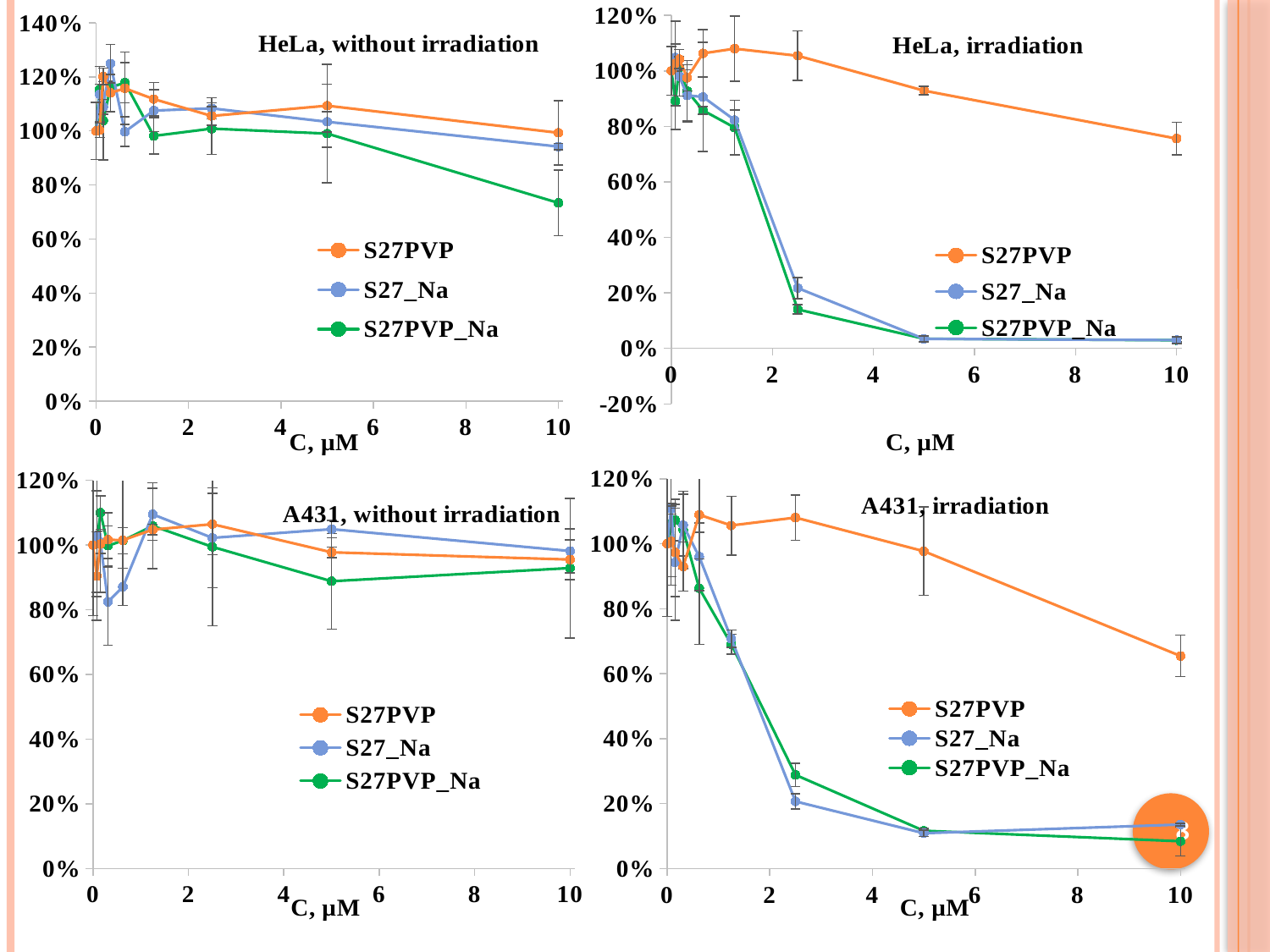
In the 'HeLa, irradiation' chart, is the value for S27_Na at 5 µM greater or less than 20%? less In the 'HeLa, without irradiation' chart, is the value for S27PVP_Na at 10 µM greater or less than 80%? less In the 'HeLa, irradiation' chart, do the values for S27PVP_Na rise or fall as concentration increases from 1.25 to 10 µM? fall How many series does the legend of the 'A431, irradiation' chart list? 3 In the 'A431, irradiation' chart, is the value for S27PVP at 10 µM greater or less than 80%? less What kind of chart is the 'HeLa, irradiation' chart? line chart What is the x-axis label of the 'A431, without irradiation' chart? C, µM What is the title of the top-left chart on the slide? HeLa, without irradiation In the 'A431, irradiation' chart, which series has the larger value at 2.5 µM, S27PVP_Na or S27_Na? S27PVP_Na In the 'HeLa, irradiation' chart, which series has the larger value at 10 µM, S27PVP or S27_Na? S27PVP